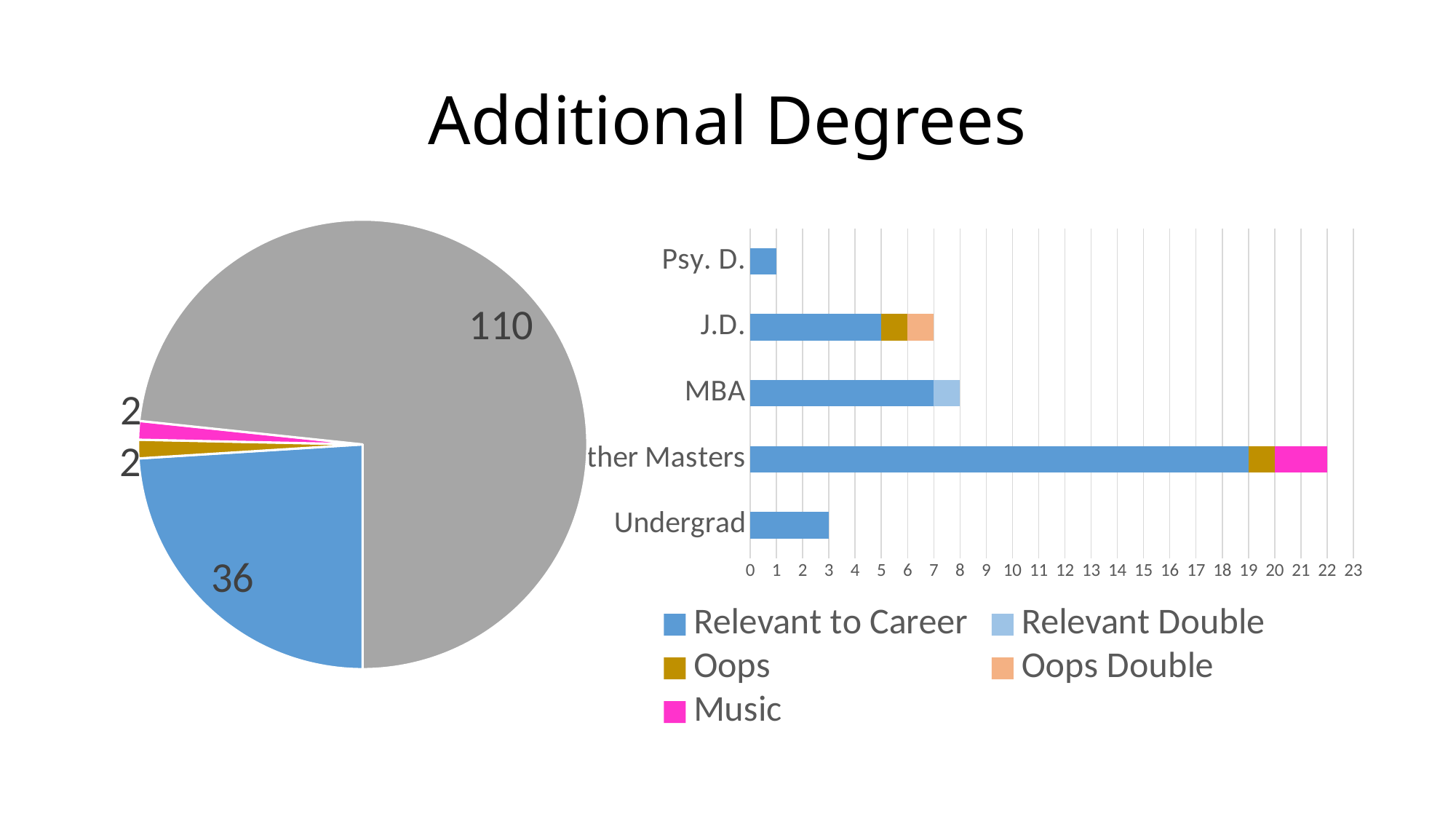
In the bar chart on the right, which category has the shortest bar? Psy. D. How many series does the legend of the bar chart on the right list? 5 What kind of chart is the chart on the right of the slide? bar chart In the bar chart on the right, what is the Relevant to Career value for MBA? 7 In the pie chart on the left, what is the value of the largest slice? 110 In the pie chart on the left, what is the difference between the largest slice and the blue slice? 74 In the pie chart on the left, what is the value of the blue slice? 36 How many slices does the pie chart on the left have? 4 In the bar chart on the right, what is the total length of the stacked bar for J.D.? 7 In the bar chart on the right, which has the larger total bar, Undergrad or Psy. D.? Undergrad In the pie chart on the left, what share of the whole pie does the slice labelled 36 represent? 24% In the bar chart on the right, what is the Relevant to Career value for Undergrad? 3